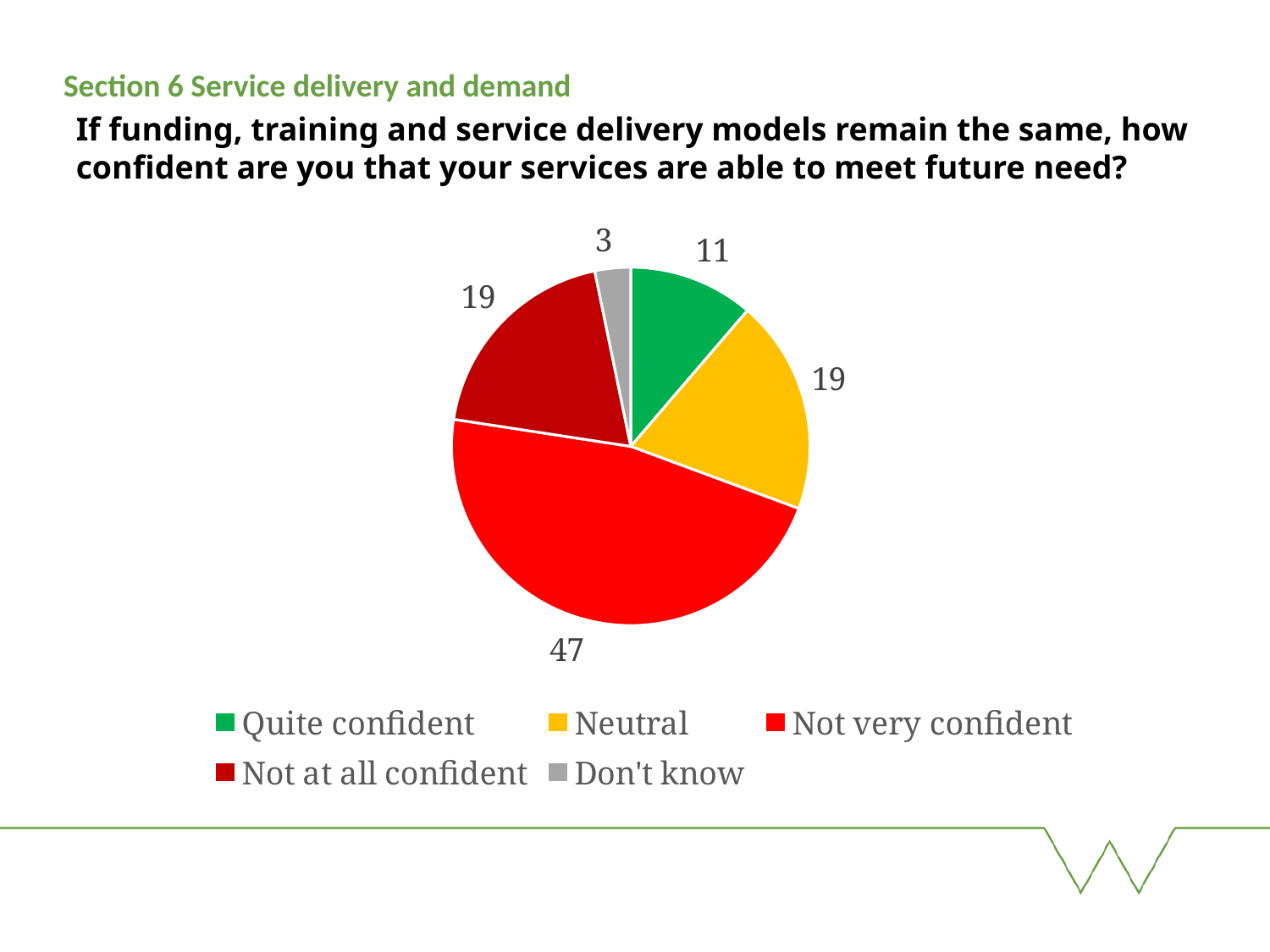
Which category has the largest slice of the pie? Not very confident Which is larger, the value for Quite confident or the value for Neutral? Neutral What value is shown for the Don't know slice? 3 How many slices does the pie chart have? 5 What is the difference between the values for Neutral and Quite confident? 8 What value is shown for the Neutral slice? 19 What colour is the Not very confident slice? Red What value is shown for the Quite confident slice? 11 Which category has the smallest slice of the pie? Don't know What value is shown for the Not very confident slice? 47 What is the difference between the values for Not very confident and Not at all confident? 28 What kind of chart is shown on the slide? Pie chart